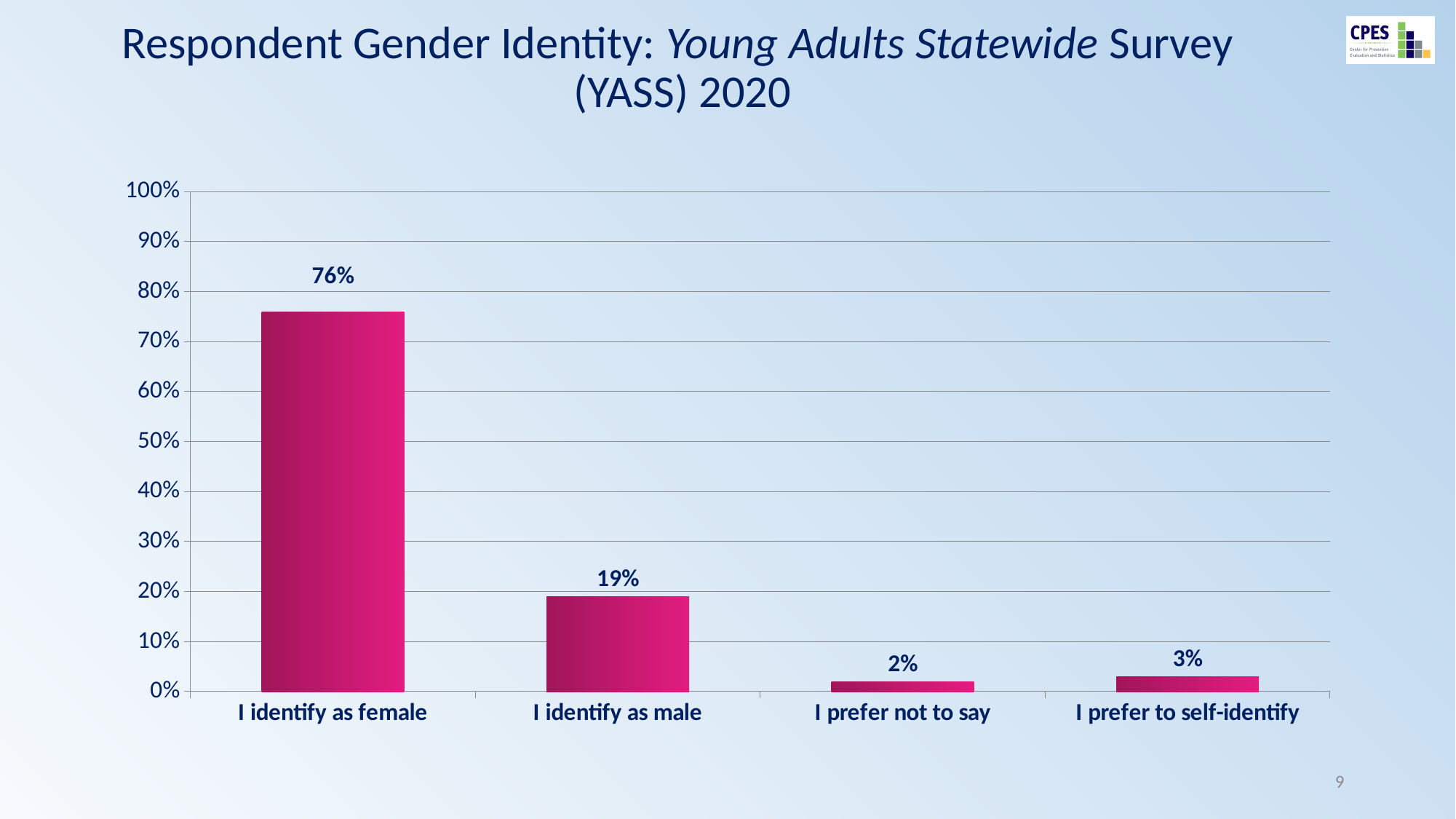
Which response category has the highest percentage? I identify as female What percentage of respondents selected "I identify as female"? 76% Which response category has the lowest percentage? I prefer not to say What kind of chart is shown on the slide? Bar chart Which is larger: the value for "I prefer to self-identify" or the value for "I prefer not to say"? I prefer to self-identify What percentage of respondents selected "I identify as male"? 19% What is the title of the slide? Respondent Gender Identity: Young Adults Statewide Survey (YASS) 2020 Is the value for "I identify as male" greater or less than 20%? less What percentage of respondents selected "I prefer to self-identify"? 3% How many response categories are shown on the chart? 4 What percentage of respondents selected "I prefer not to say"? 2% What is the difference in percentage points between "I identify as female" and "I identify as male"? 57